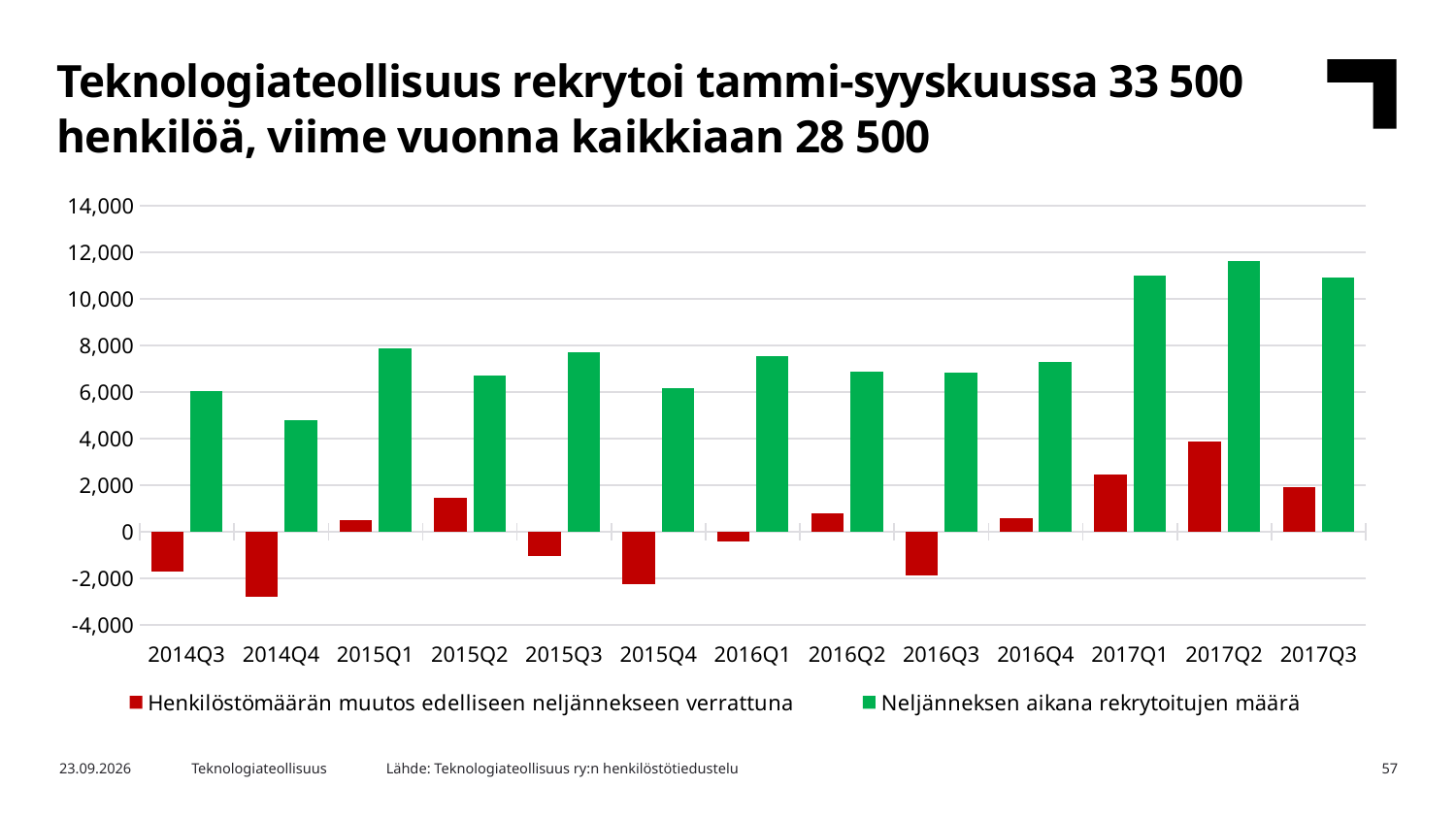
Which quarter has the highest value for Henkilöstömäärän muutos edelliseen neljännekseen verrattuna? 2017Q2 Which quarter has the highest value for Neljänneksen aikana rekrytoitujen määrä? 2017Q2 Which quarter has the lowest value for Henkilöstömäärän muutos edelliseen neljännekseen verrattuna? 2014Q4 Is the value for Neljänneksen aikana rekrytoitujen määrä in 2017Q1 greater or less than 10,000? greater What kind of chart is shown on the slide? bar chart Which quarter has the lowest value for Neljänneksen aikana rekrytoitujen määrä? 2014Q4 How many quarters are shown on the x axis? 13 How many series does the legend list? 2 Which colour represents Neljänneksen aikana rekrytoitujen määrä in the legend? green Which is larger, the value for Neljänneksen aikana rekrytoitujen määrä in 2017Q2 or in 2016Q4? 2017Q2 Is the value for Neljänneksen aikana rekrytoitujen määrä in 2014Q4 greater or less than 6,000? less Is the value for Henkilöstömäärän muutos edelliseen neljännekseen verrattuna in 2014Q4 greater or less than -2,000? less